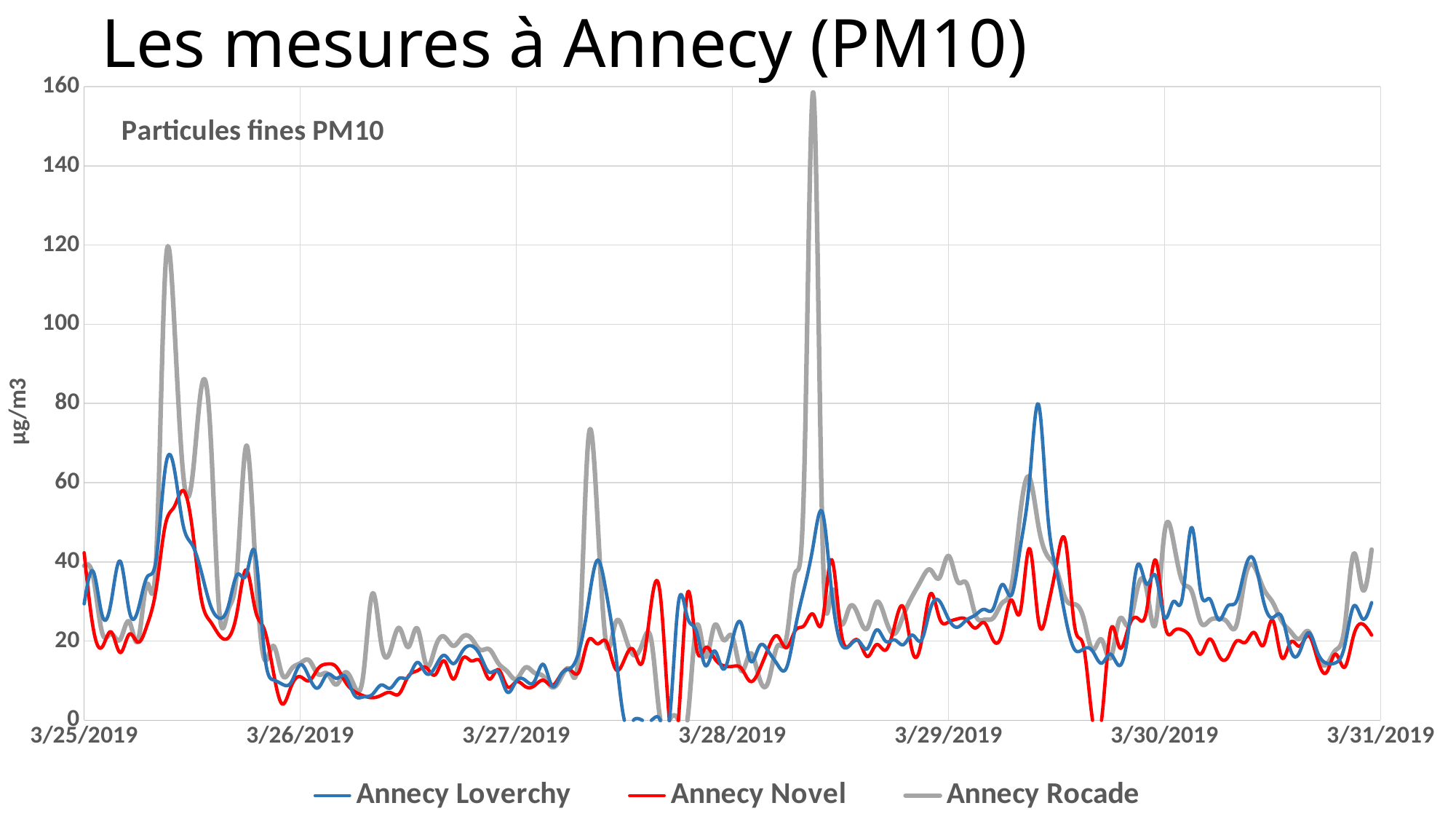
Does Annecy Novel ever exceed 80 µg/m3 on the chart? No Which series has the lowest peak shortly after 3/25/2019? Annecy Novel What is the title of the slide? Les mesures à Annecy (PM10) How many date labels are shown on the horizontal axis? 7 What unit is shown on the vertical axis? µg/m3 How many series does the legend list? 3 Is the peak of Annecy Loverchy shortly after 3/29/2019 greater or less than 60? greater What kind of chart is shown on the slide? line chart Is the highest peak of Annecy Rocade, just after 3/28/2019, greater or less than 140? greater Which series has the highest peak shortly after 3/29/2019, Annecy Loverchy or Annecy Rocade? Annecy Loverchy Which series reaches the highest value anywhere on the chart? Annecy Rocade